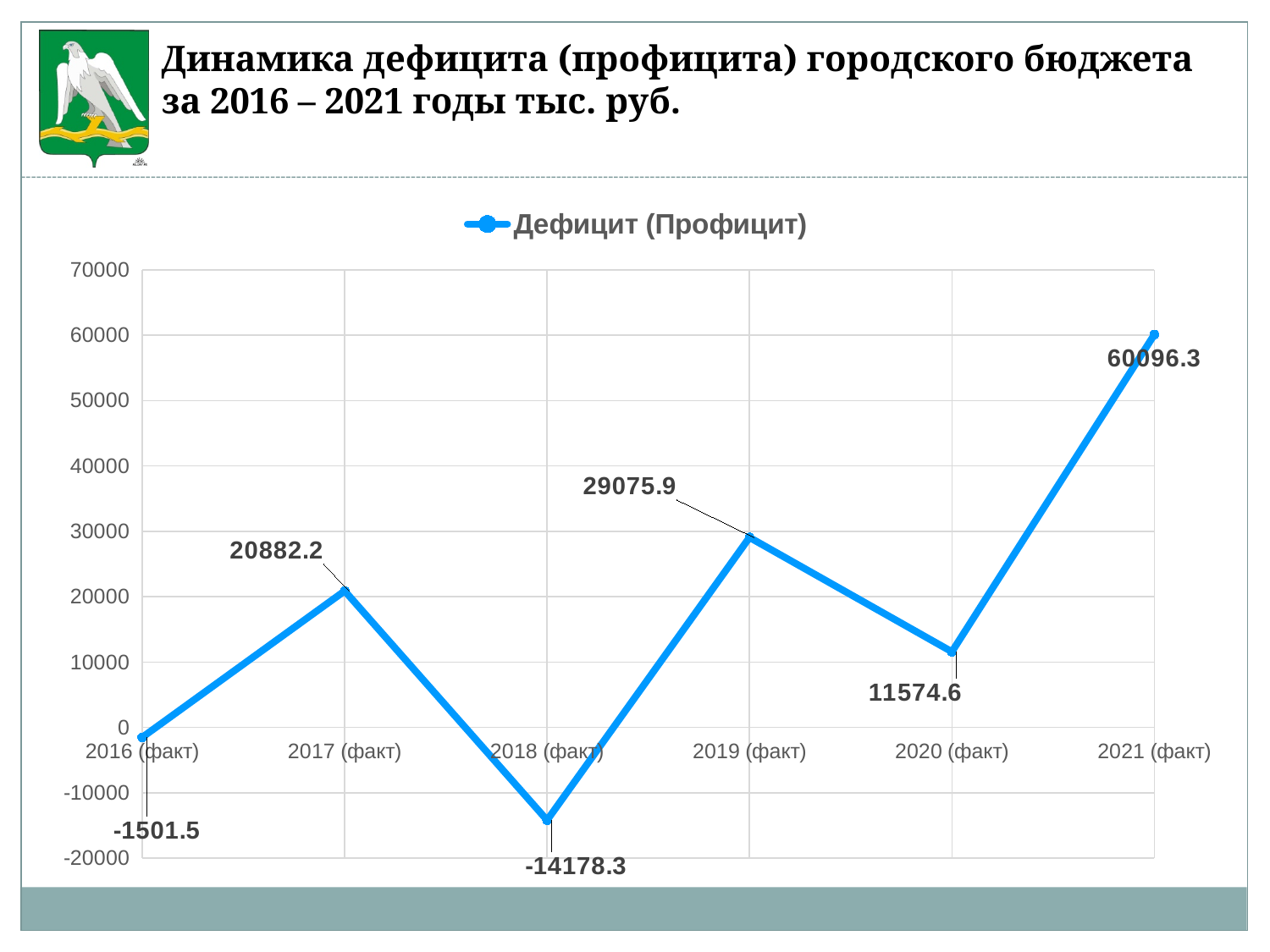
What is the difference between the values for 2017 (факт) and 2020 (факт)? 9307.6 Which is larger, the value for 2019 (факт) or the value for 2020 (факт)? 2019 (факт) How many years are plotted on the chart? 6 What is the value for 2021 (факт)? 60096.3 Which year has the lowest value? 2018 (факт) What kind of chart is shown on the slide? line chart What is the value for 2018 (факт)? -14178.3 What is the name of the series shown in the legend? Дефицит (Профицит) What is the value for 2016 (факт)? -1501.5 What is the difference between the values for 2021 (факт) and 2019 (факт)? 31020.4 Which year has the highest value? 2021 (факт) What is the value for 2017 (факт)? 20882.2